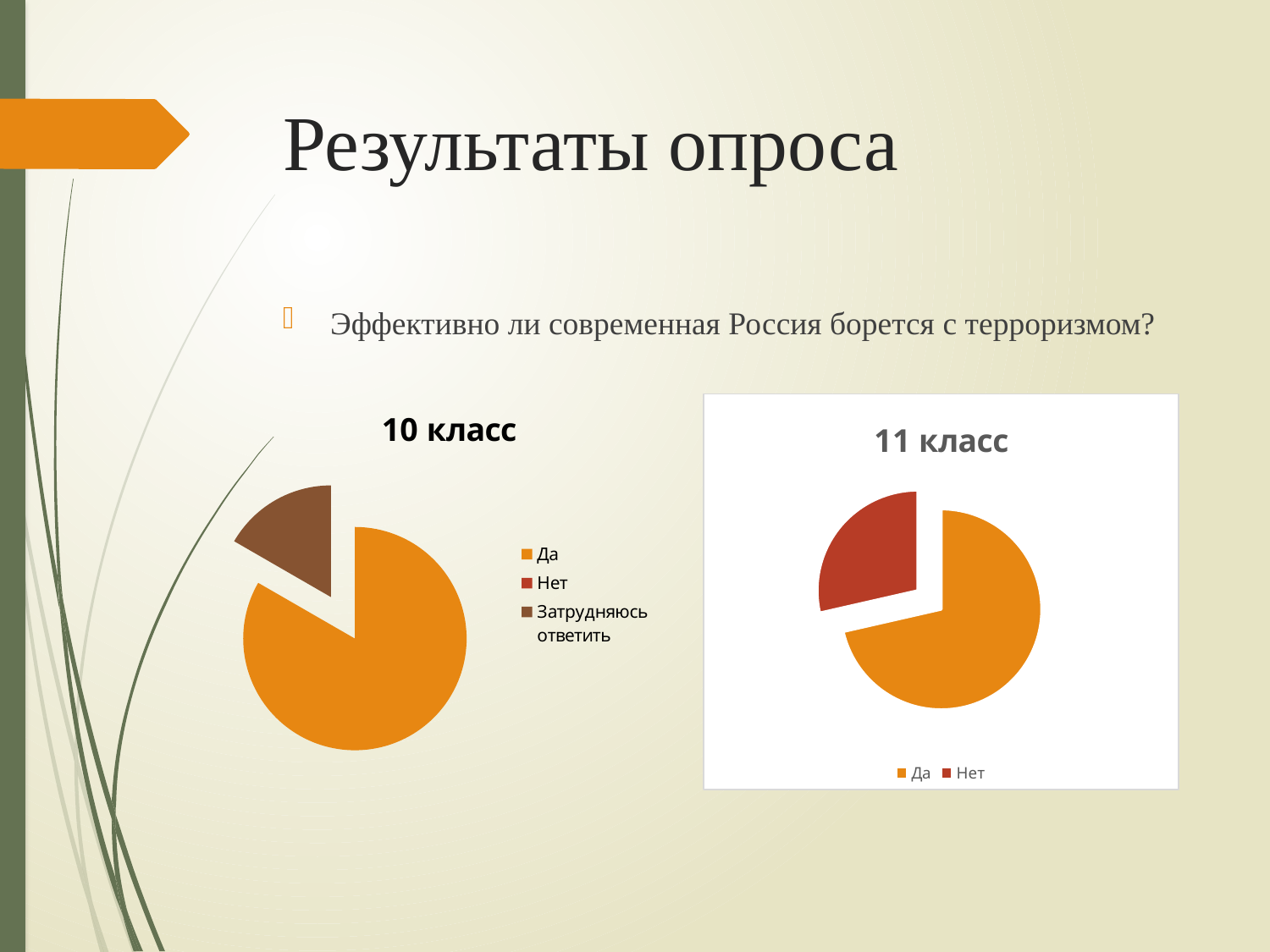
What kind of chart is the "11 класс" chart? pie chart How many entries does the legend of the "10 класс" chart list? 3 In the "11 класс" chart, which category has the smallest slice? Нет In the "10 класс" chart, which slice is larger, Да or Затрудняюсь ответить? Да What is the title of the pie chart on the right side of the slide? 11 класс What kind of chart is the "10 класс" chart? pie chart In the "11 класс" chart, what colour is the slice for Нет? red How many entries does the legend of the "11 класс" chart list? 2 In the "11 класс" chart, which category has the largest slice? Да In the "11 класс" chart, which slice is larger, Да or Нет? Да In the "10 класс" chart, which category has the largest slice? Да